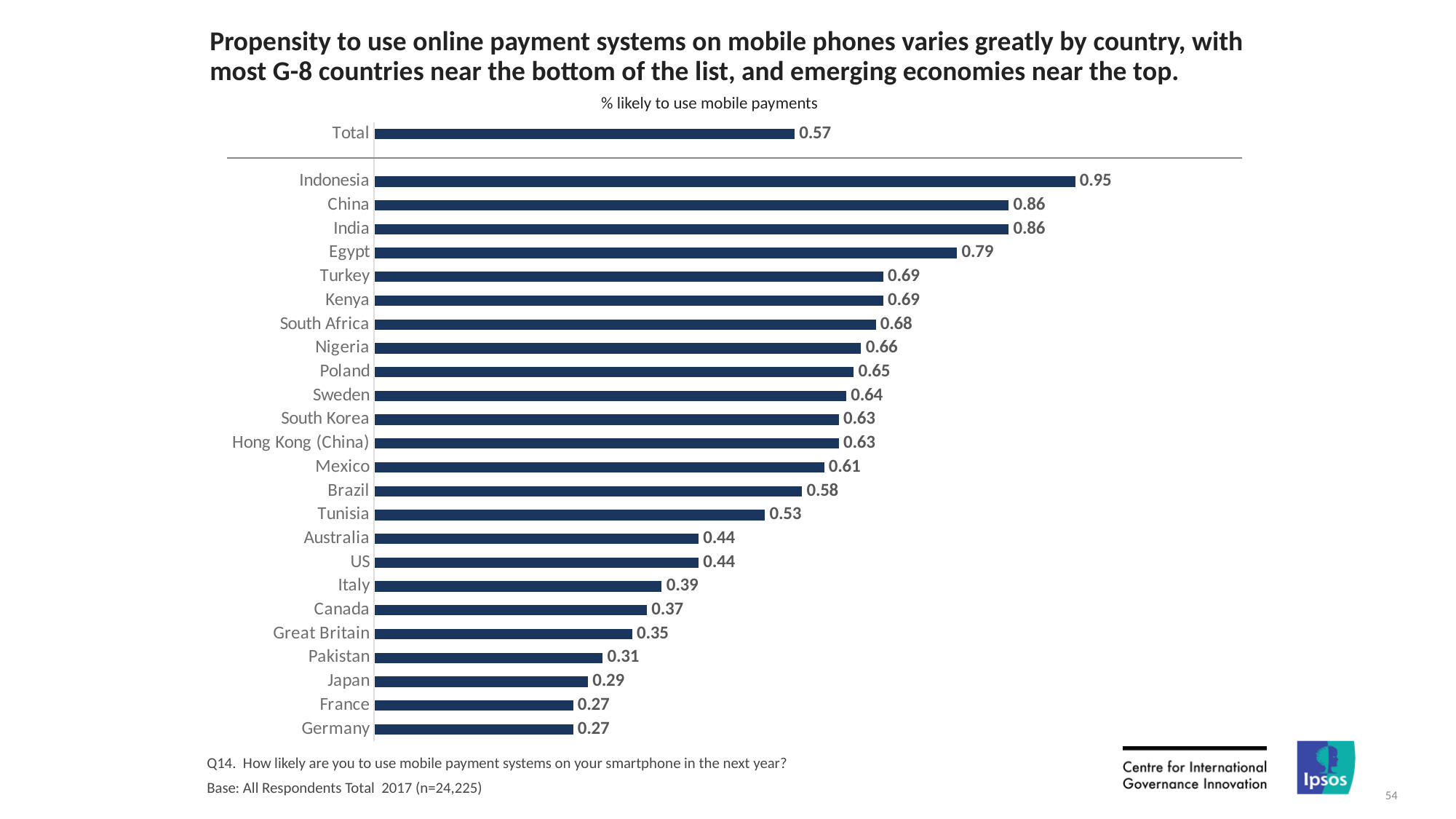
What is the difference between the values for Egypt and Brazil? 0.21 What is the value shown for Indonesia? 0.95 What is the subtitle printed directly above the chart? % likely to use mobile payments Which has a larger value, Mexico or Tunisia? Mexico Which country has the highest value on the chart? Indonesia What kind of chart is shown on the slide? Bar chart What is the value shown for Japan? 0.29 How many country bars are shown below the Total bar? 24 What is the value shown for the Total bar? 0.57 Which has a larger value, Pakistan or Italy? Italy What is the value shown for Canada? 0.37 What is the difference between the values for Indonesia and Germany? 0.68